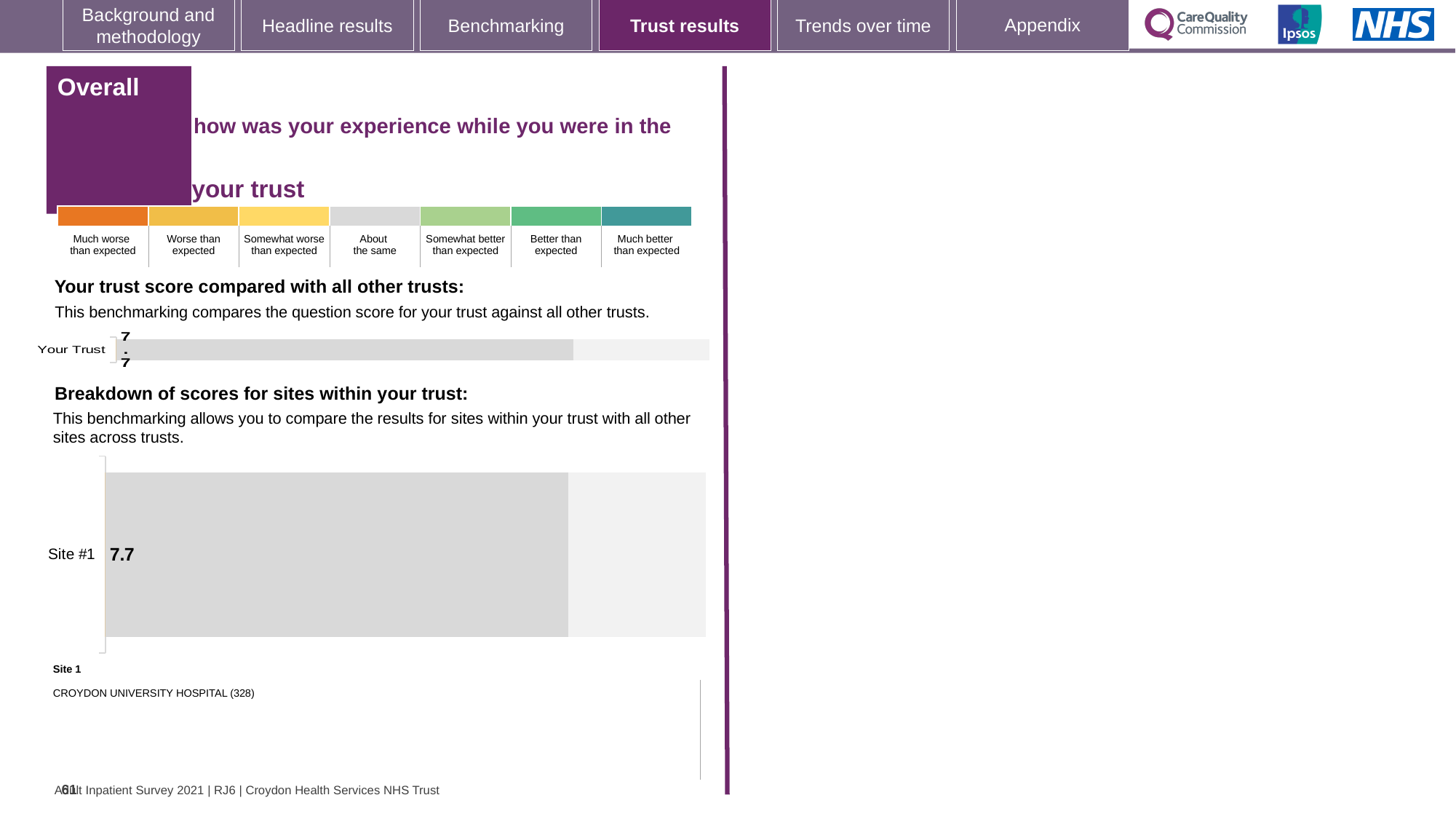
What kind of chart is the 'Breakdown of scores for sites within your trust' chart? bar chart What is the difference between the Site #1 score in the breakdown chart and the Your Trust score in the trust comparison chart? 0.0 According to the note below the breakdown chart, which hospital is Site 1? CROYDON UNIVERSITY HOSPITAL (328) How many sites are plotted in the 'Breakdown of scores for sites within your trust' chart? 1 In the 'Your trust score compared with all other trusts' chart, what is the score shown for Your Trust? 7.7 How many rating categories are shown in the colour key above the charts, from 'Much worse than expected' to 'Much better than expected'? 7 Is the score for Site #1 in the breakdown chart larger than, smaller than, or equal to the Your Trust score in the trust comparison chart? equal How many bars are plotted in the 'Your trust score compared with all other trusts' chart? 1 What kind of chart is the 'Your trust score compared with all other trusts' chart? bar chart In the 'Breakdown of scores for sites within your trust' chart, what is the score shown for Site #1? 7.7